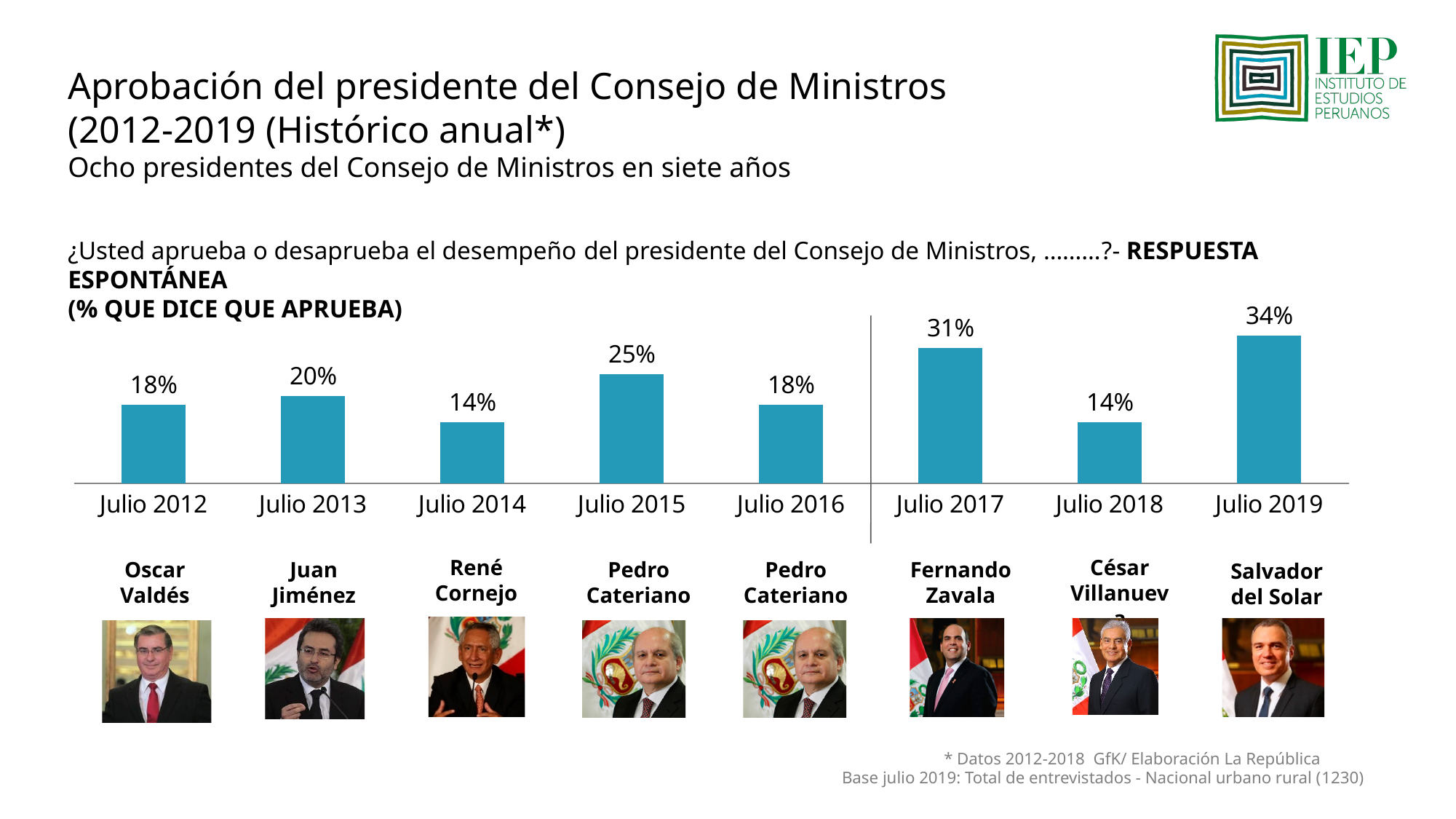
How many bars are shown in the chart? 8 What is the approval value for Julio 2015? 25% What is the approval value for Julio 2013? 20% Which period has the highest approval value? Julio 2019 What is the difference between the approval values for Julio 2017 and Julio 2016? 13% What kind of chart is shown on the slide? Bar chart Which periods share the same approval value of 18%? Julio 2012 and Julio 2016 What is the difference between the approval values for Julio 2019 and Julio 2018? 20% What is the approval value for Julio 2019? 34% What is the lowest approval value shown in the chart? 14% Which president of the Consejo de Ministros is shown under the Julio 2017 bar? Fernando Zavala Which is larger, the approval value for Julio 2015 or for Julio 2013? Julio 2015